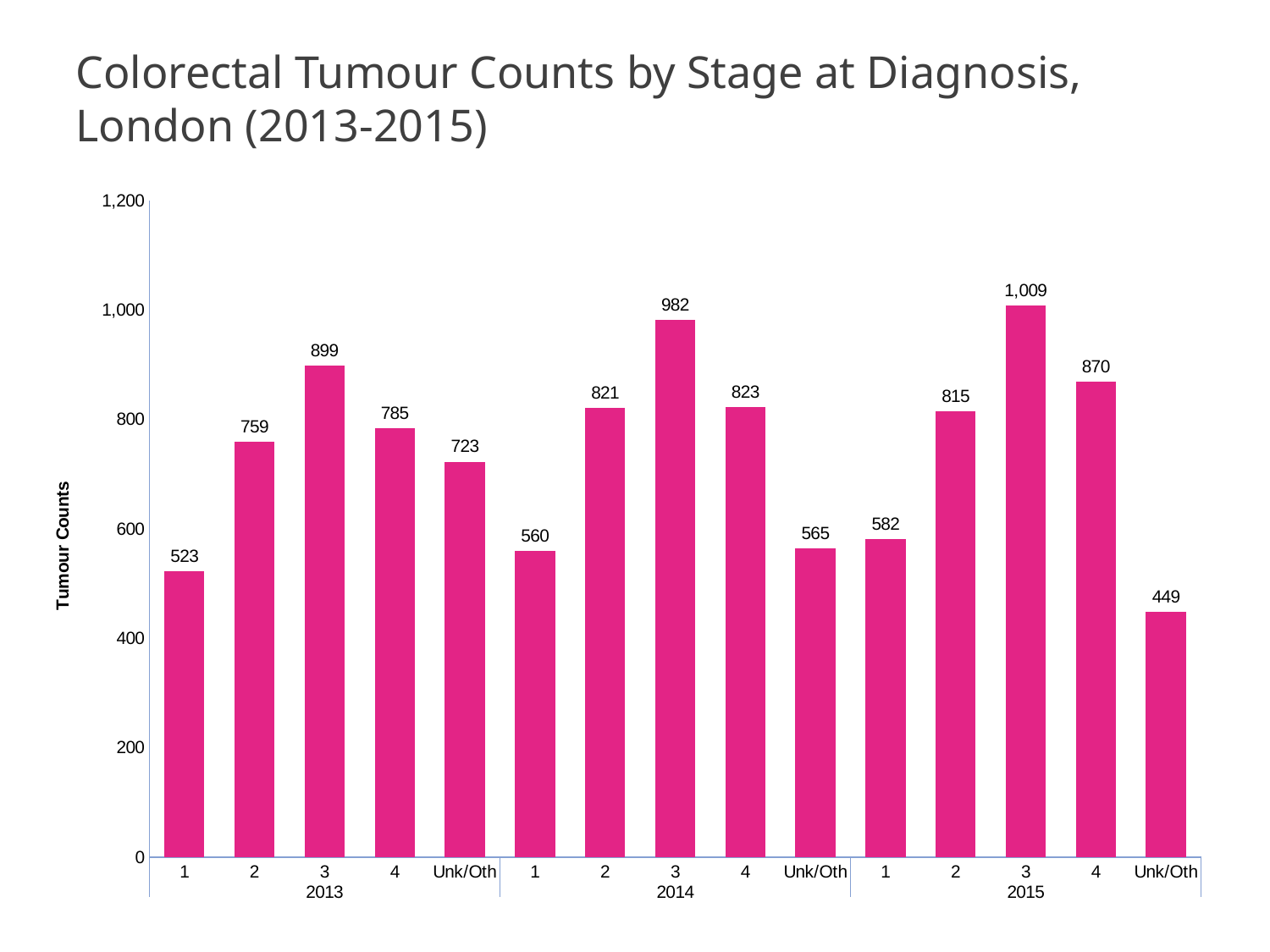
Which bar has the lowest tumour count? Unk/Oth, 2015 Is the value for stage 2 in 2013 greater or less than 800? less What is the tumour count for Unk/Oth in 2013? 723 How many bars are plotted on the chart? 15 Does the stage 1 tumour count rise or fall from 2013 to 2015? Rise What is the tumour count for stage 1 in 2014? 560 What is the difference between the stage 3 count in 2014 and the stage 3 count in 2013? 83 Which bar has the highest tumour count? Stage 3, 2015 What is the label of the vertical axis? Tumour Counts What kind of chart is shown on the slide? Bar chart Which is larger: the stage 4 count in 2013 or the stage 4 count in 2015? Stage 4 in 2015 What is the tumour count for stage 3 in 2015? 1,009